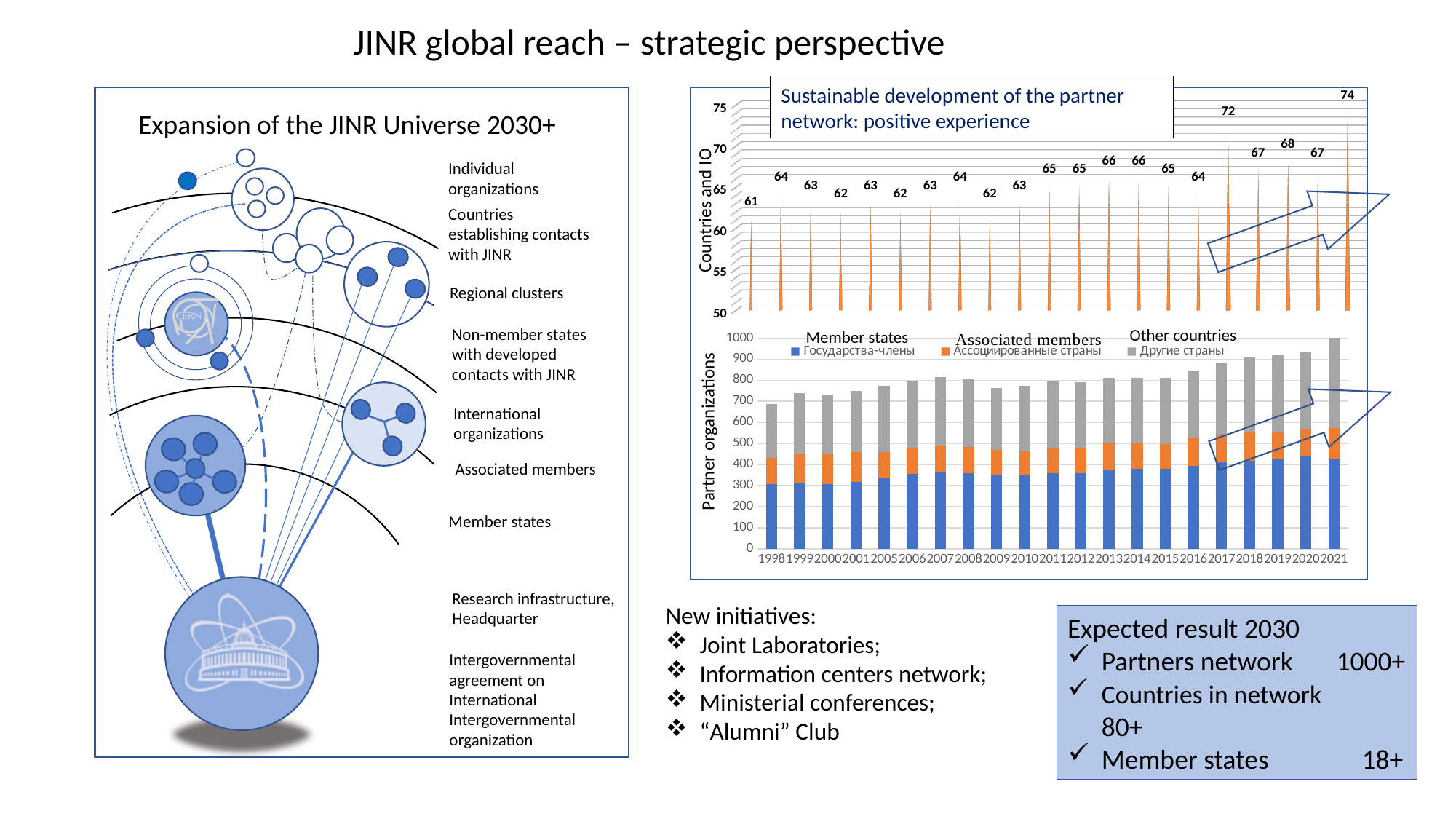
In the lower 'Partner organizations' chart, is the total stacked bar for 1998 greater or less than 800? less In the upper 'Countries and IO' chart, what is the highest data label shown? 74 How many series does the legend of the lower 'Partner organizations' chart list? 3 In the lower 'Partner organizations' chart, which year has the tallest total bar? 2021 How many years are shown on the x axis of the lower 'Partner organizations' chart? 21 In the upper 'Countries and IO' chart, what is the lowest data label shown? 61 In the upper 'Countries and IO' chart, what is the difference between the highest data label (74) and the lowest data label (61)? 13 What is the y-axis title of the upper chart on the slide? Countries and IO What type of chart is the lower chart labelled 'Partner organizations'? Stacked bar chart In the lower 'Partner organizations' chart, is the Member states value for 1998 greater or less than 400? less In the lower 'Partner organizations' chart, is the total stacked bar for 2021 greater or less than 900? greater In the lower 'Partner organizations' chart, do the total bar heights generally rise or fall from 1998 to 2021? rise